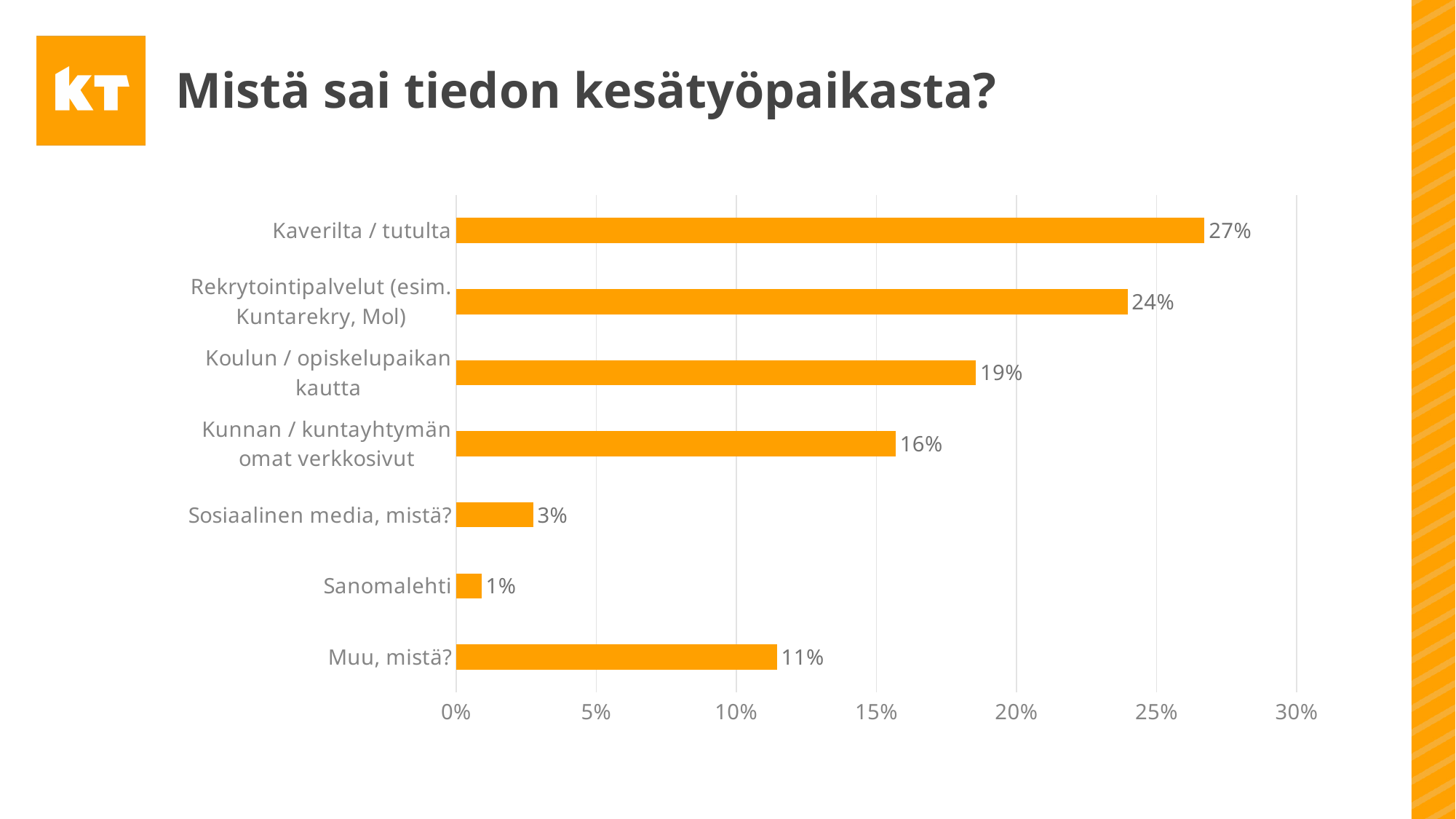
What is the value for Sosiaalinen media, mistä? 3% What is the title of the slide? Mistä sai tiedon kesätyöpaikasta? Which category has the highest value? Kaverilta / tutulta What kind of chart is shown on the slide? bar chart Which category has the lowest value? Sanomalehti What is the value for Kaverilta / tutulta? 27% What is the difference between Koulun / opiskelupaikan kautta and Kunnan / kuntayhtymän omat verkkosivut? 3% Is the value for Kunnan / kuntayhtymän omat verkkosivut greater or less than 20%? less What is the value for Muu, mistä? 11% Which is larger, Muu, mistä? or Sosiaalinen media, mistä? Muu, mistä? How many categories are shown in the chart? 7 What is the value for Rekrytointipalvelut (esim. Kuntarekry, Mol)? 24%